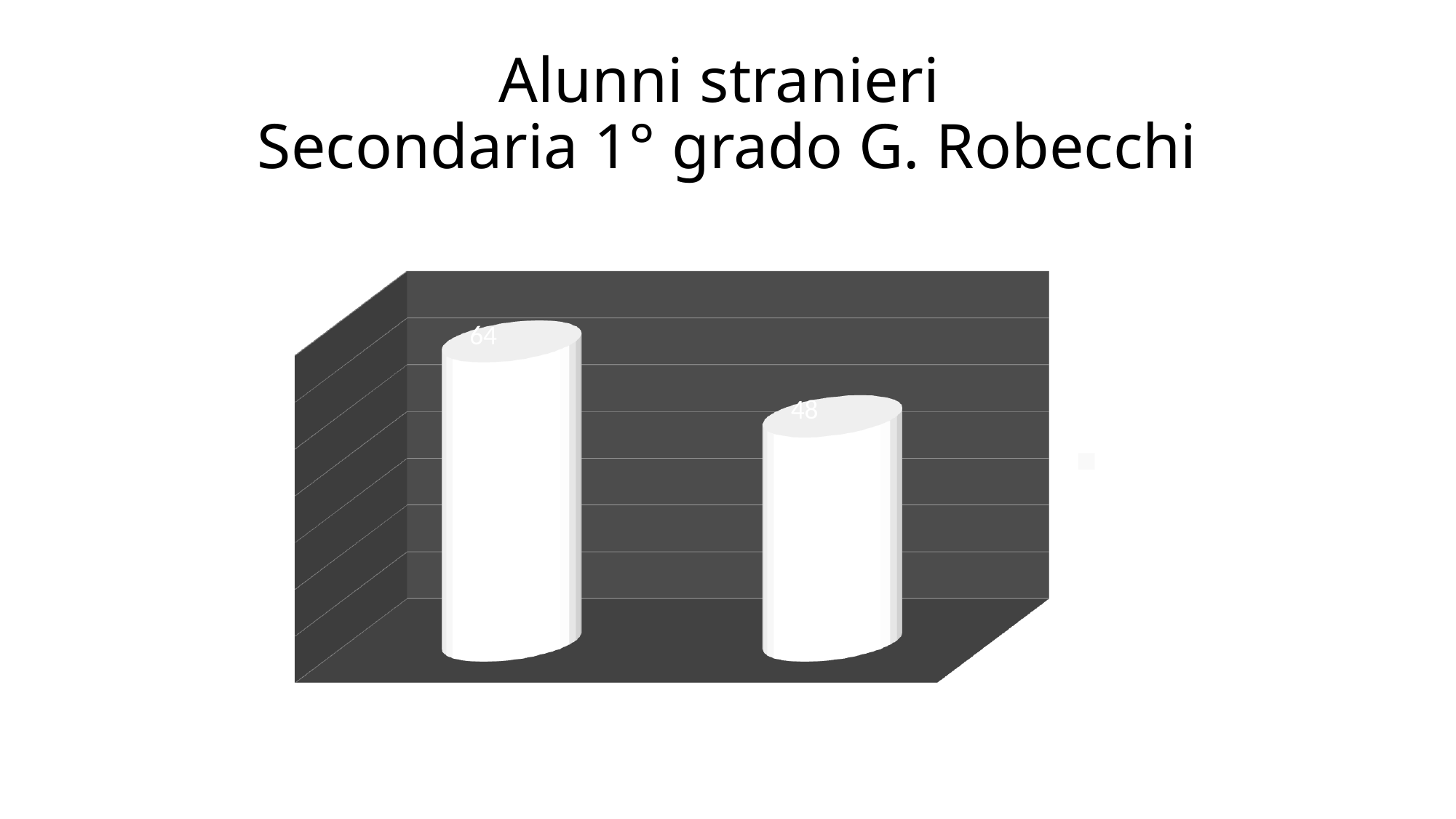
Which bar has the higher value, the left one or the right one? the left one Is the value of the left bar larger or smaller than the value of the right bar? larger Do the values fall or rise from the left bar to the right bar? fall What is the difference between the values of the left bar and the right bar? 16 Which bar has the lower value, the left one or the right one? the right one What is the value shown on the left bar of the chart? 64 How many bars are plotted in the chart? 2 What is the total of the two values shown in the chart? 112 What is the title of the chart? Alunni stranieri Secondaria 1° grado G. Robecchi What is the value shown on the right bar of the chart? 48 What kind of chart is shown on the slide? bar chart